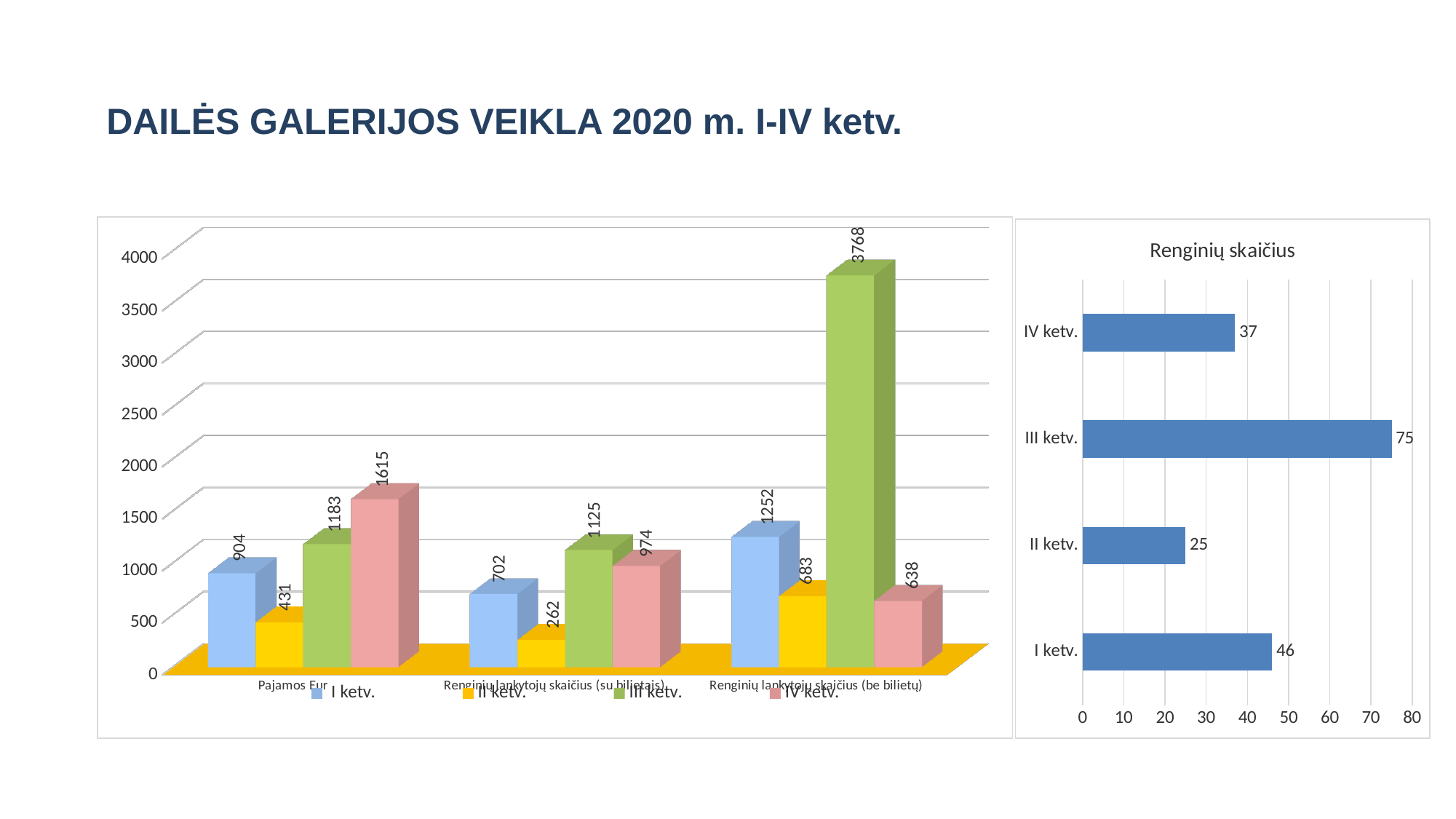
In the chart titled "Renginių skaičius", what is the value for III ketv.? 75 In the left chart, which is larger for Pajamos Eur: the I ketv. value or the II ketv. value? I ketv. In the left chart, what is the value of the IV ketv. series for Pajamos Eur? 1615 In the left chart, what colour are the bars for the II ketv. series? Yellow In the left chart, how many series does the legend list? 4 In the chart titled "Renginių skaičius", how many bars are plotted? 4 In the chart titled "Renginių skaičius", which quarter has the lowest value? II ketv. In the left chart, what is the value of the III ketv. series for Renginių lankytojų skaičius (be bilietų)? 3768 What kind of chart is the chart titled "Renginių skaičius"? Bar chart In the chart titled "Renginių skaičius", what is the difference between the values for III ketv. and I ketv.? 29 In the left chart, what is the difference between the I ketv. and II ketv. values for Renginių lankytojų skaičius (be bilietų)? 569 In the left chart, which series has the highest value for Renginių lankytojų skaičius (su bilietais)? III ketv.